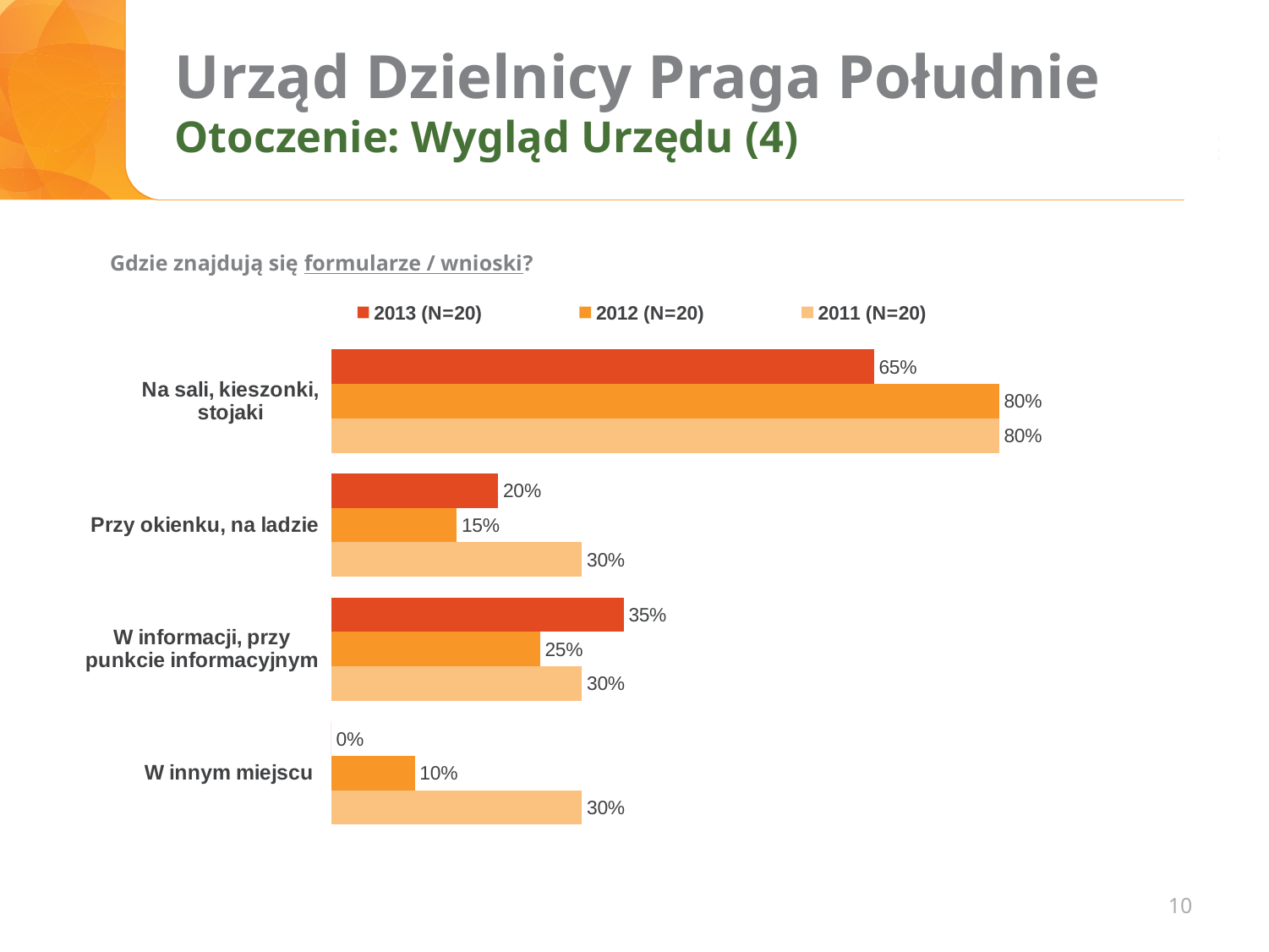
What kind of chart is shown on the slide? Bar chart What is the difference between the 2012 and 2013 values for 'Na sali, kieszonki, stojaki'? 15% What is the value for 'W innym miejscu' in the 2013 (N=20) series? 0% What question does the chart answer, as stated above it? Gdzie znajdują się formularze / wnioski? What is the value for 'Przy okienku, na ladzie' in the 2011 (N=20) series? 30% Which category has the highest value in the 2013 (N=20) series? Na sali, kieszonki, stojaki How many categories are shown on the chart? 4 Which is larger for 'Przy okienku, na ladzie': the 2013 value or the 2012 value? 2013 What is the value for 'Na sali, kieszonki, stojaki' in the 2013 (N=20) series? 65% What is the value for 'W informacji, przy punkcie informacyjnym' in the 2012 (N=20) series? 25% How many series does the legend list? 3 Which category has the lowest value in the 2012 (N=20) series? W innym miejscu